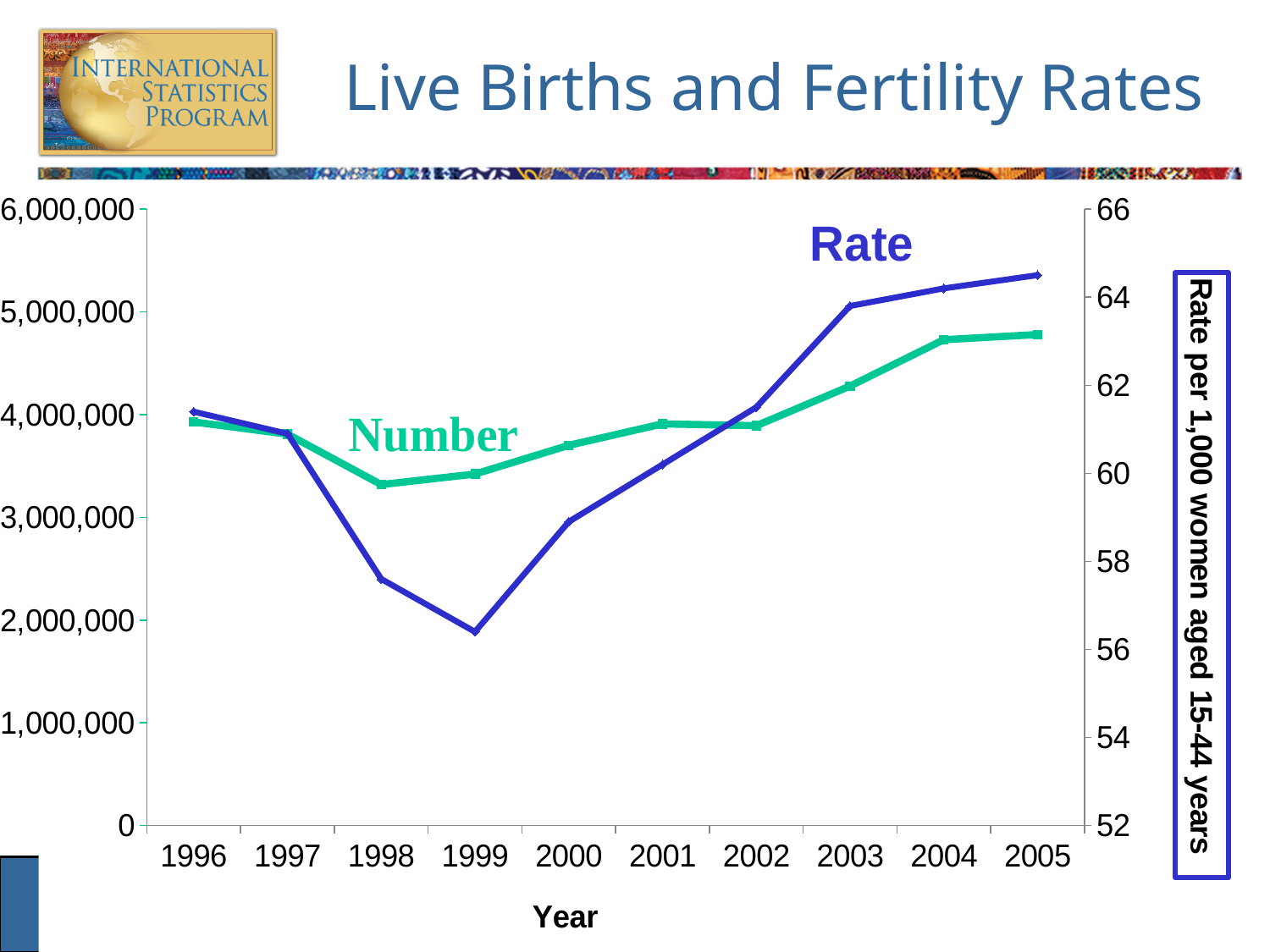
What is the label on the right-hand vertical axis? Rate per 1,000 women aged 15-44 years How many years are shown along the x axis? 10 Is the Rate value for 2005 greater or less than 64? greater Is the Number value for 2005 greater or less than 4,000,000? greater In which year is the Rate series at its lowest? 1999 Does the Rate series rise or fall from 1999 to 2005? rise How many series are plotted on the chart? 2 What kind of chart is shown on the slide? line chart What is the title of the chart? Live Births and Fertility Rates Is the Rate value for 1999 greater or less than 58? less In which year is the Rate series at its highest? 2005